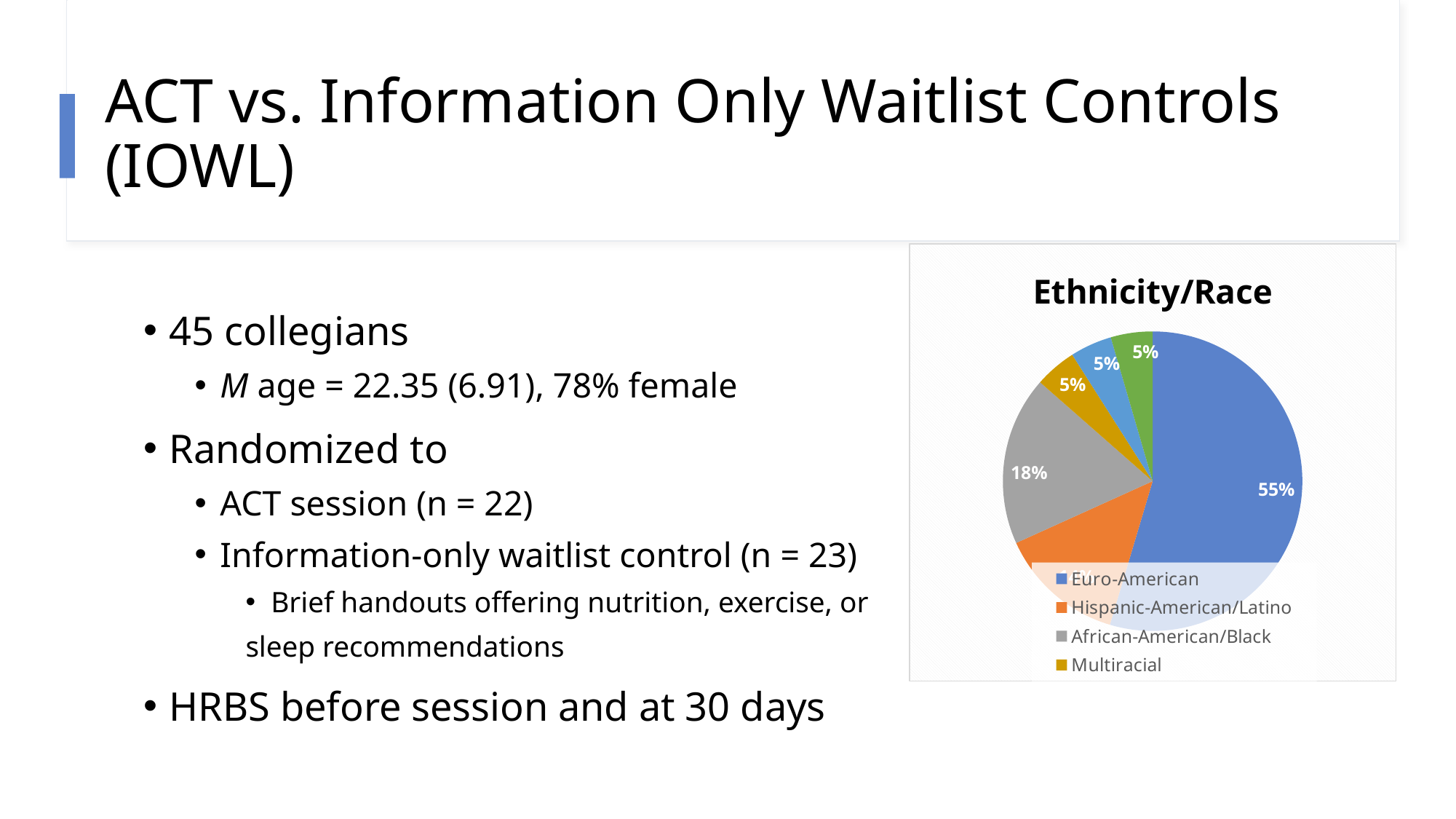
What percentage of the Ethnicity/Race pie is African-American/Black? 18% What is the difference in percentage points between the Euro-American and African-American/Black slices? 37 percentage points How many slices does the Ethnicity/Race pie chart have? 6 Does the Euro-American slice make up more or less than half of the Ethnicity/Race pie? More What is the title of the chart on the slide? Ethnicity/Race Which is larger in the Ethnicity/Race pie chart, African-American/Black or Multiracial? African-American/Black Which category has the largest slice in the Ethnicity/Race pie chart? Euro-American How many entries are readable in the legend of the Ethnicity/Race pie chart? 4 Which is larger in the Ethnicity/Race pie chart, Euro-American or African-American/Black? Euro-American What percentage of the Ethnicity/Race pie is Euro-American? 55% What percentage of the Ethnicity/Race pie is Multiracial? 5% What kind of chart is shown on the slide? Pie chart